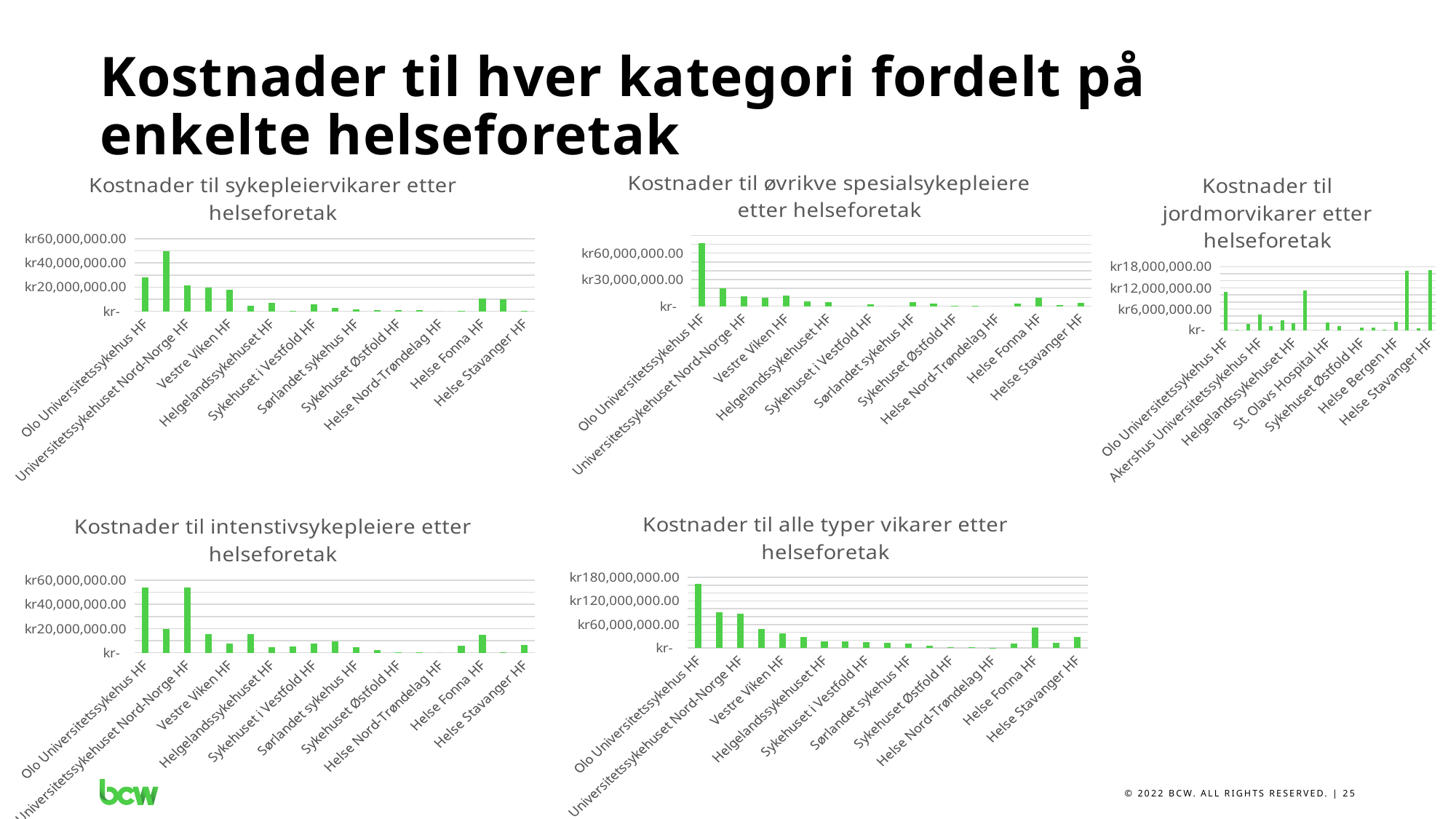
In the chart "Kostnader til alle typer vikarer etter helseforetak", is the value for Universitetssykehuset Nord-Norge HF greater or less than kr120,000,000.00? less In the chart "Kostnader til jordmorvikarer etter helseforetak", is the value for Helgelandssykehuset HF greater or less than kr6,000,000.00? less In the chart "Kostnader til alle typer vikarer etter helseforetak", which is larger, the value for Helse Fonna HF or Helse Stavanger HF? Helse Fonna HF In the chart "Kostnader til alle typer vikarer etter helseforetak", which helseforetak has the highest cost? Olo Universitetssykehus HF In the chart "Kostnader til øvrikve spesialsykepleiere etter helseforetak", is the value for Universitetssykehuset Nord-Norge HF greater or less than kr30,000,000.00? less In the chart "Kostnader til øvrikve spesialsykepleiere etter helseforetak", which helseforetak has the highest cost? Olo Universitetssykehus HF What kind of chart is "Kostnader til alle typer vikarer etter helseforetak"? bar chart How many charts are shown on the slide? 5